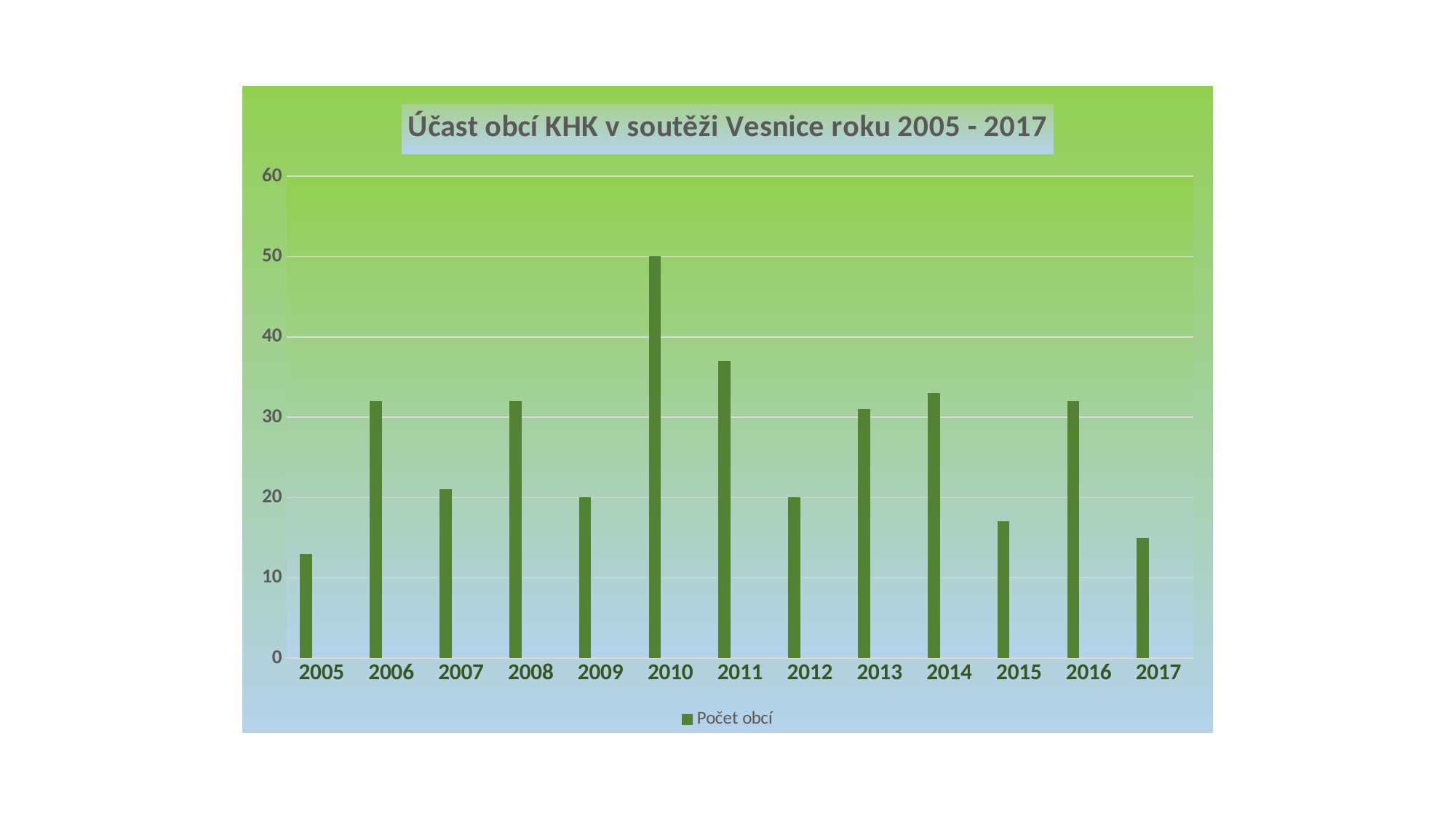
What is the value for 2010? 50 Which is larger, the value for 2011 or the value for 2013? 2011 How many series does the legend list? 1 How many years are shown on the x axis? 13 Is the value for 2017 greater or less than 20? less What is the title of the chart? Účast obcí KHK v soutěži Vesnice roku 2005 - 2017 What kind of chart is shown on the slide? bar chart Is the value for 2011 greater or less than 30? greater What is the name of the series shown in the legend? Počet obcí Which year has the highest value? 2010 Is the value for 2015 greater or less than 20? less Which year has the lowest value? 2005